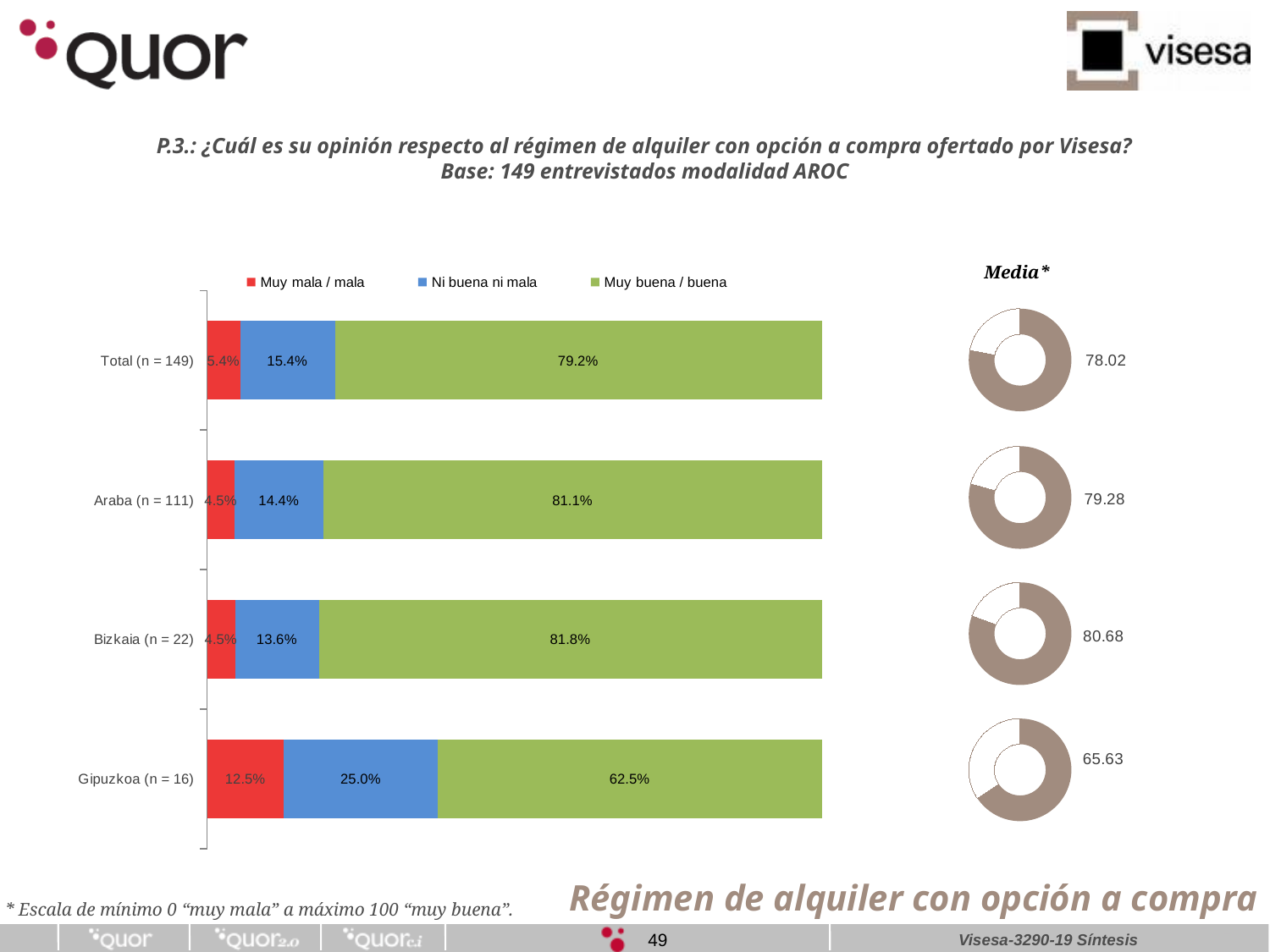
In the stacked bar chart, what is the value of "Muy buena / buena" for Total (n = 149)? 79.2% In the stacked bar chart, which category has the lowest "Muy buena / buena" value? Gipuzkoa (n = 16) In the stacked bar chart, which category has the highest "Muy buena / buena" value? Bizkaia (n = 22) What kind of chart is the chart on the left of the slide? Stacked bar chart In the stacked bar chart, is the "Muy mala / mala" value larger for Gipuzkoa (n = 16) or for Total (n = 149)? Gipuzkoa (n = 16) How many series does the legend of the stacked bar chart list? 3 In the stacked bar chart, what is the value of "Ni buena ni mala" for Gipuzkoa (n = 16)? 25.0% In the Media* donut charts, what is the value shown for Bizkaia (n = 22)? 80.68 In the Media* donut charts, which category has the lowest value? Gipuzkoa (n = 16) In the stacked bar chart, what is the value of "Muy mala / mala" for Araba (n = 111)? 4.5% In the stacked bar chart, what is the difference between the "Ni buena ni mala" values for Gipuzkoa (n = 16) and Bizkaia (n = 22)? 11.4% How many categories are shown in the stacked bar chart? 4